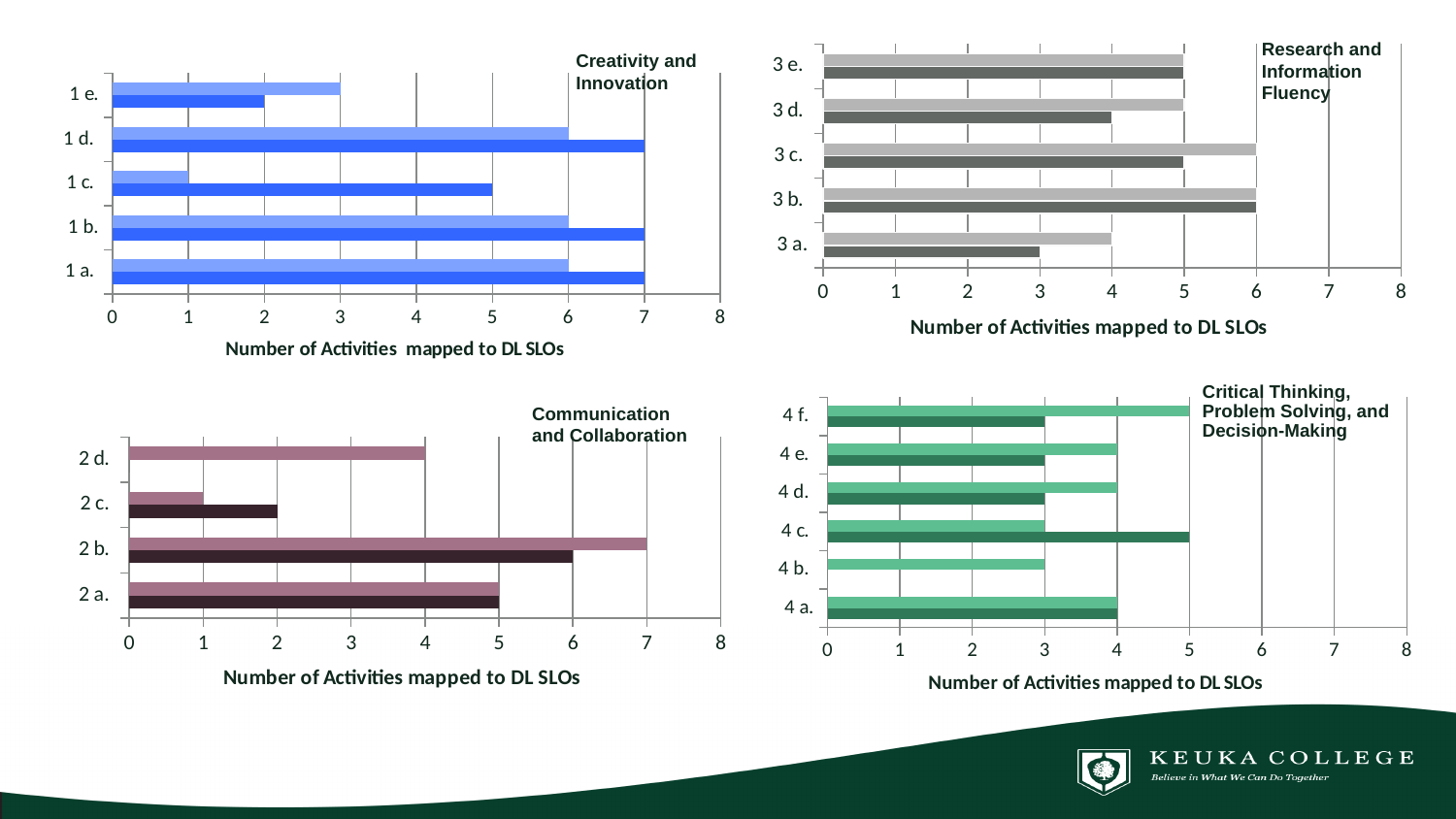
In the Research and Information Fluency chart, what is the value of the darker gray bar for 3 a.? 3 In the Creativity and Innovation chart, what is the value of the darker blue bar for 1 d.? 7 What type of chart is the Critical Thinking, Problem Solving, and Decision-Making chart? bar chart In the Research and Information Fluency chart, how many categories are shown on the vertical axis? 5 In the Critical Thinking, Problem Solving, and Decision-Making chart, what is the value of the darker green bar for 4 c.? 5 In the Research and Information Fluency chart, is the lighter gray bar for 3 c. longer or shorter than the lighter gray bar for 3 a.? longer In the Creativity and Innovation chart, which category has the shortest lighter blue bar? 1 c. In the Creativity and Innovation chart, what is the value of the lighter blue bar for 1 e.? 3 In the Communication and Collaboration chart, what is the value of the lighter pink bar for 2 d.? 4 In the Creativity and Innovation chart, what is the difference between the darker blue bar and the lighter blue bar for 1 c.? 4 In the Communication and Collaboration chart, what is the difference between the lighter pink bar and the darker bar for 2 b.? 1 In the Communication and Collaboration chart, which category has the longest bar? 2 b.